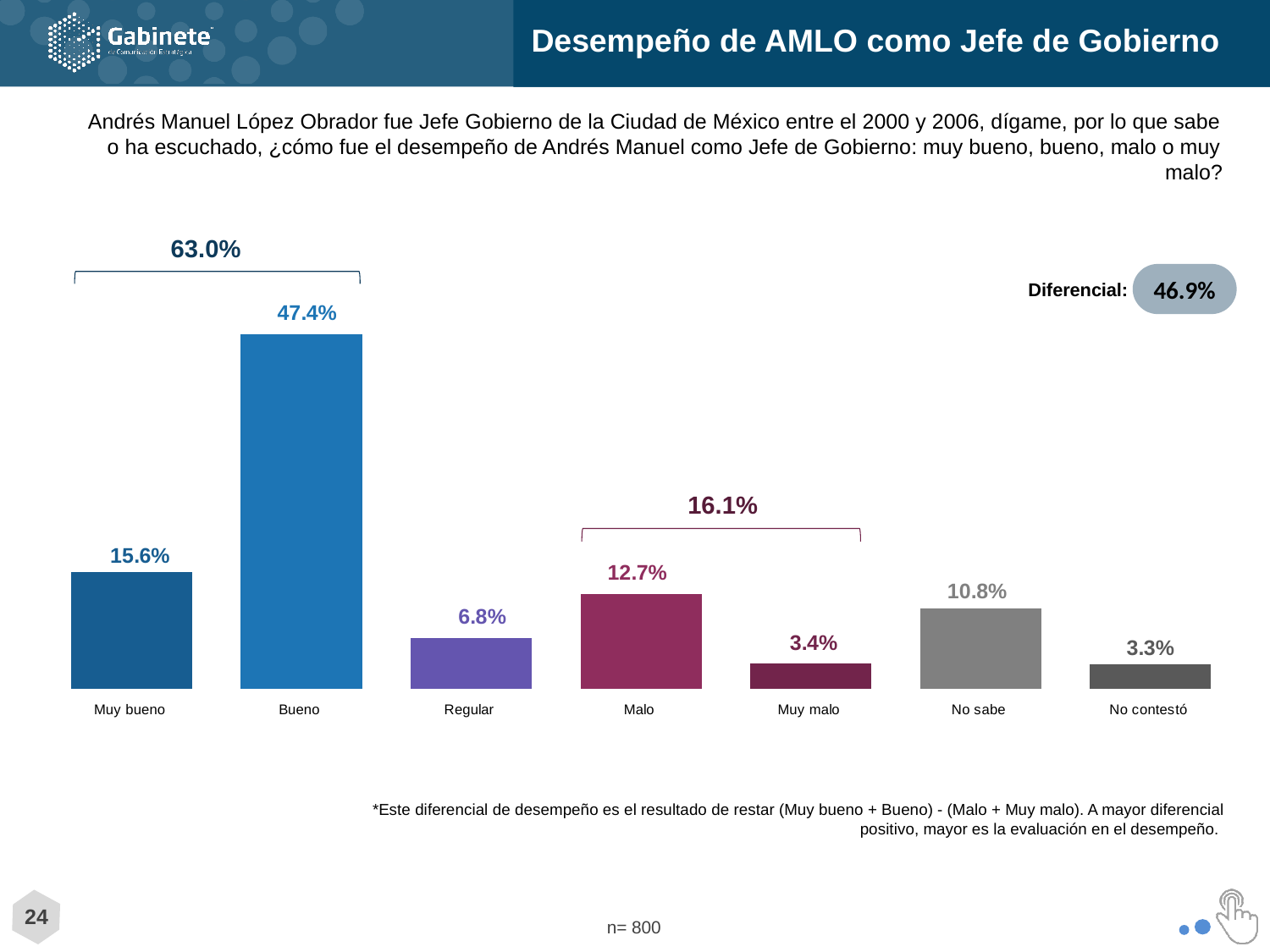
What is the value for No sabe? 10.8% What is the value for Bueno? 47.4% What is the value for Muy bueno? 15.6% What is the combined value shown for Malo and Muy malo? 16.1% What is the Diferencial value shown on the slide? 46.9% Which is larger, the value for Malo or the value for No sabe? Malo What kind of chart is shown on the slide? Bar chart Which category has the lowest value? No contestó What is the difference between the values for Bueno and Muy bueno? 31.8% How many categories are shown on the x axis? 7 What is the value for Regular? 6.8% Which category has the highest value? Bueno